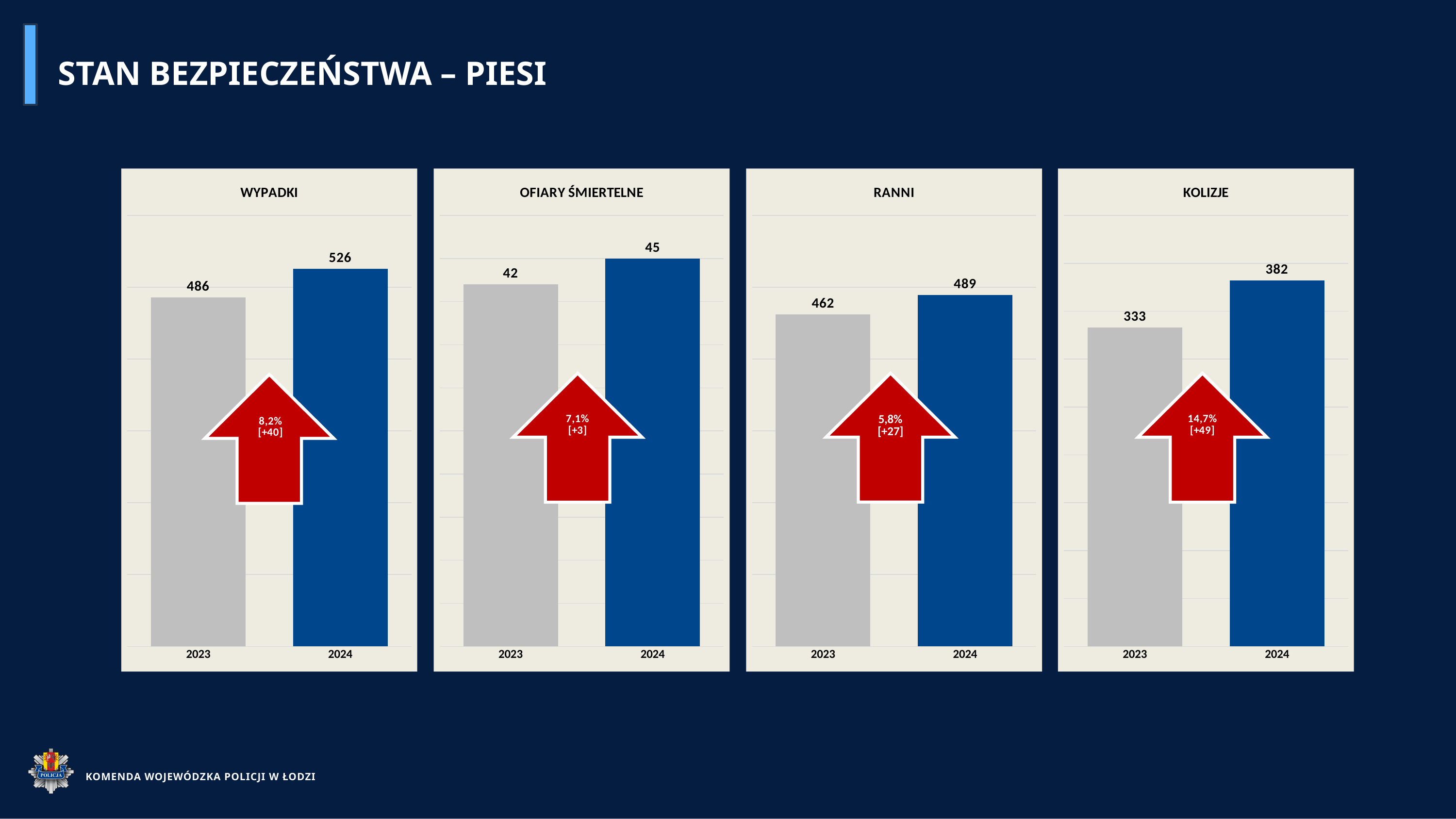
In the RANNI chart, which year has the higher value? 2024 In the KOLIZJE chart, what percentage change is shown in the red arrow? 14,7% How many bars does the KOLIZJE chart show? 2 In the WYPADKI chart, what is the value for 2024? 526 In the OFIARY ŚMIERTELNE chart, what is the value for 2023? 42 In the WYPADKI chart, do the values rise or fall from 2023 to 2024? rise In the OFIARY ŚMIERTELNE chart, what is the difference between the 2024 and 2023 values? 3 What kind of chart is the RANNI chart? bar chart In the KOLIZJE chart, what is the value for 2023? 333 In the KOLIZJE chart, what is the difference between the 2024 and 2023 values? 49 In the RANNI chart, what is the value for 2024? 489 In the WYPADKI chart, what is the value for 2023? 486